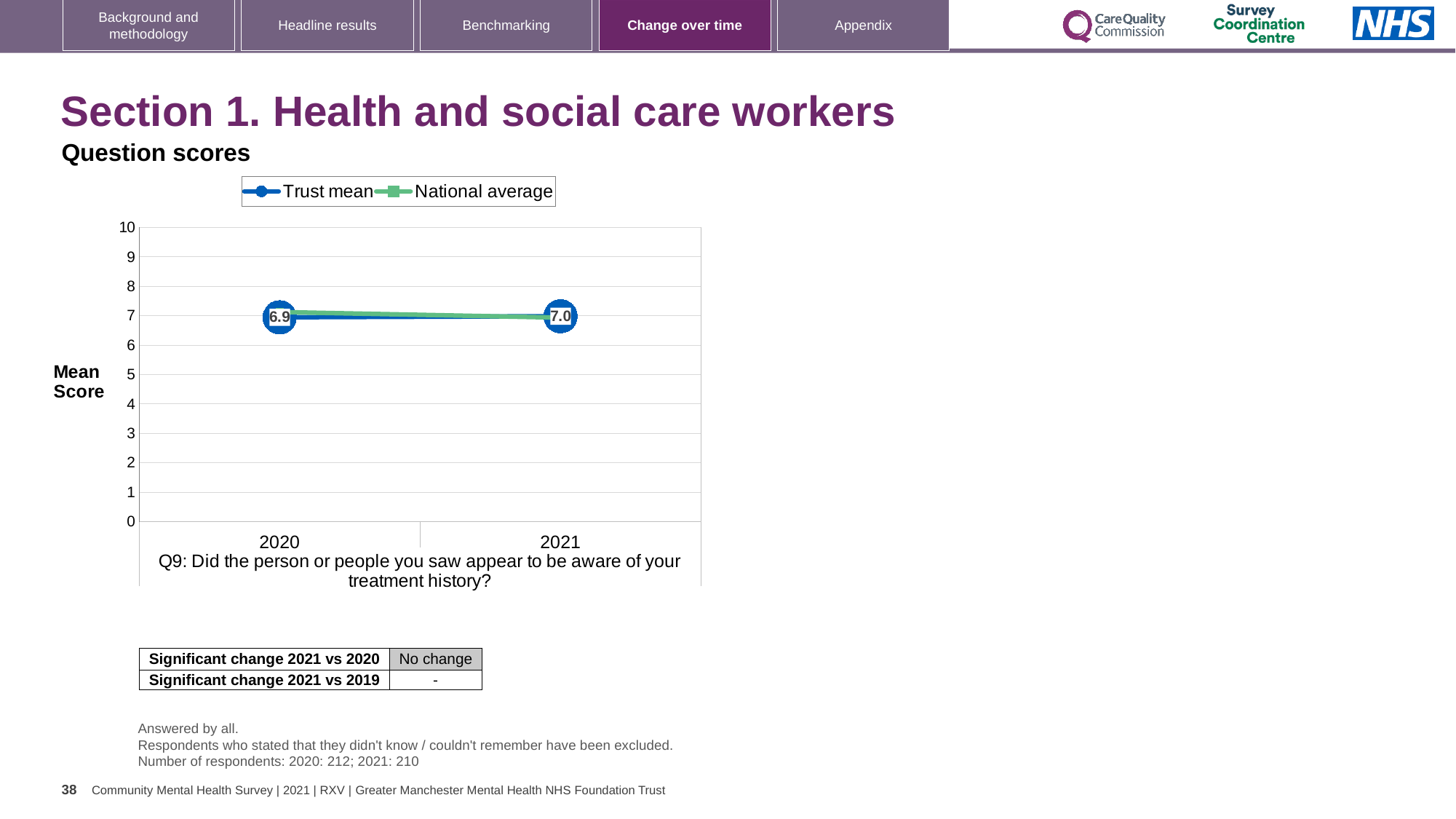
Is the National average for 2020 greater or less than 5? greater How many series does the legend list? 2 Which year has the higher Trust mean score, 2020 or 2021? 2021 What is the Trust mean score for 2020? 6.9 What is the difference between the Trust mean scores for 2021 and 2020? 0.1 What kind of chart is shown on the slide? line chart What is the label of the y axis? Mean Score Does the Trust mean rise or fall from 2020 to 2021? rise What is the Trust mean score for 2021? 7.0 Which series is shown in green in the legend? National average How many years are plotted on the x axis? 2 Is the Trust mean for 2021 greater or less than 8? less